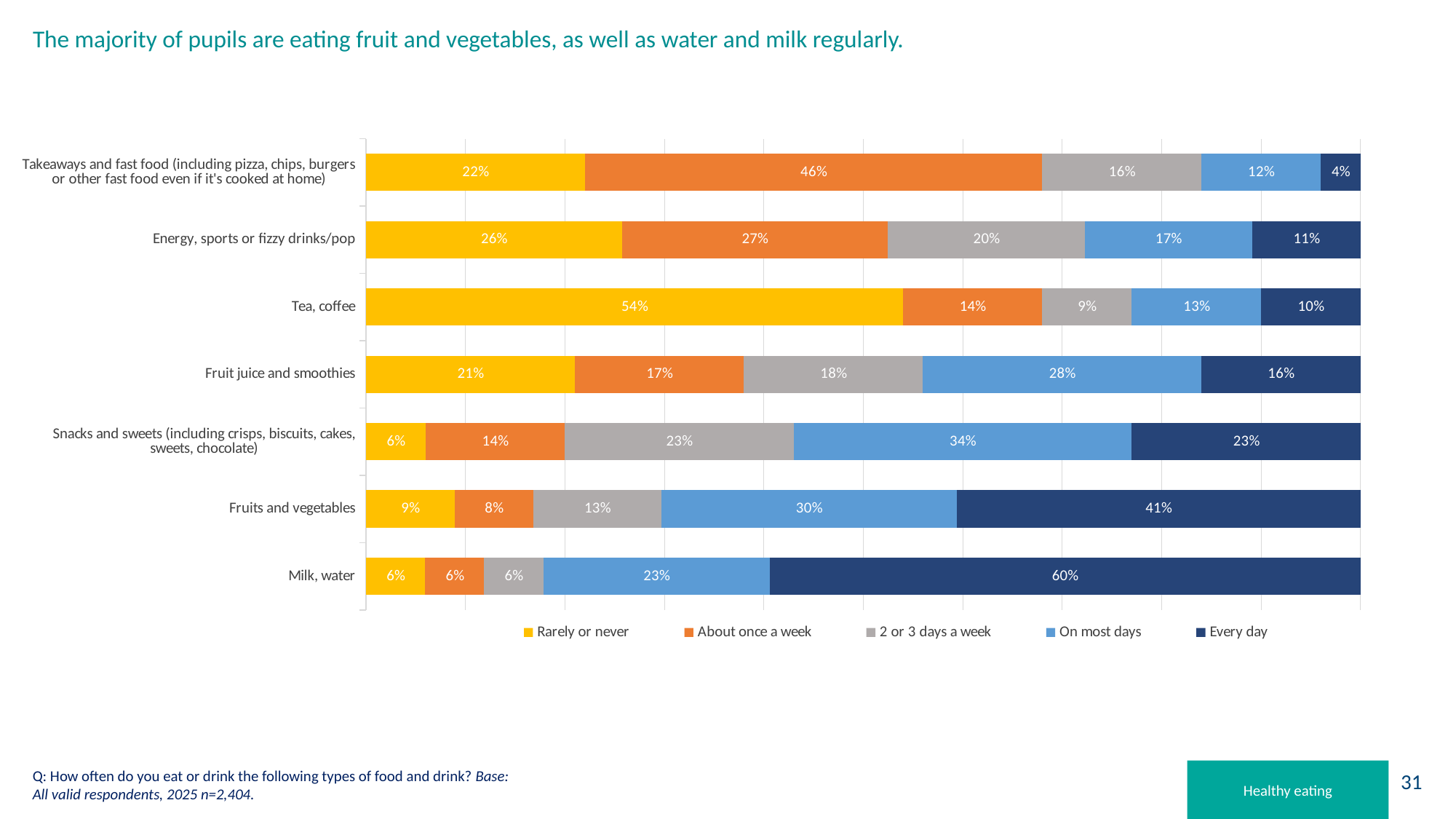
What percentage of pupils say they eat 'Fruits and vegetables' on most days? 30% Which is larger: the 'On most days' percentage for 'Snacks and sweets' or for 'Fruit juice and smoothies'? Snacks and sweets What percentage of pupils say they eat or drink 'Milk, water' every day? 60% What percentage of pupils say they have 'Tea, coffee' rarely or never? 54% What kind of chart is shown on the slide? Stacked bar chart Which category has the lowest 'Every day' percentage? Takeaways and fast food (including pizza, chips, burgers or other fast food even if it's cooked at home) Which category has the highest 'Every day' percentage? Milk, water Which legend entry is shown in yellow? Rarely or never What is the difference between the 'Every day' percentages for 'Milk, water' and 'Fruits and vegetables'? 19 percentage points How many series does the legend list? 5 What percentage of pupils say they have 'Takeaways and fast food' about once a week? 46% How many food and drink categories are shown in the chart? 7